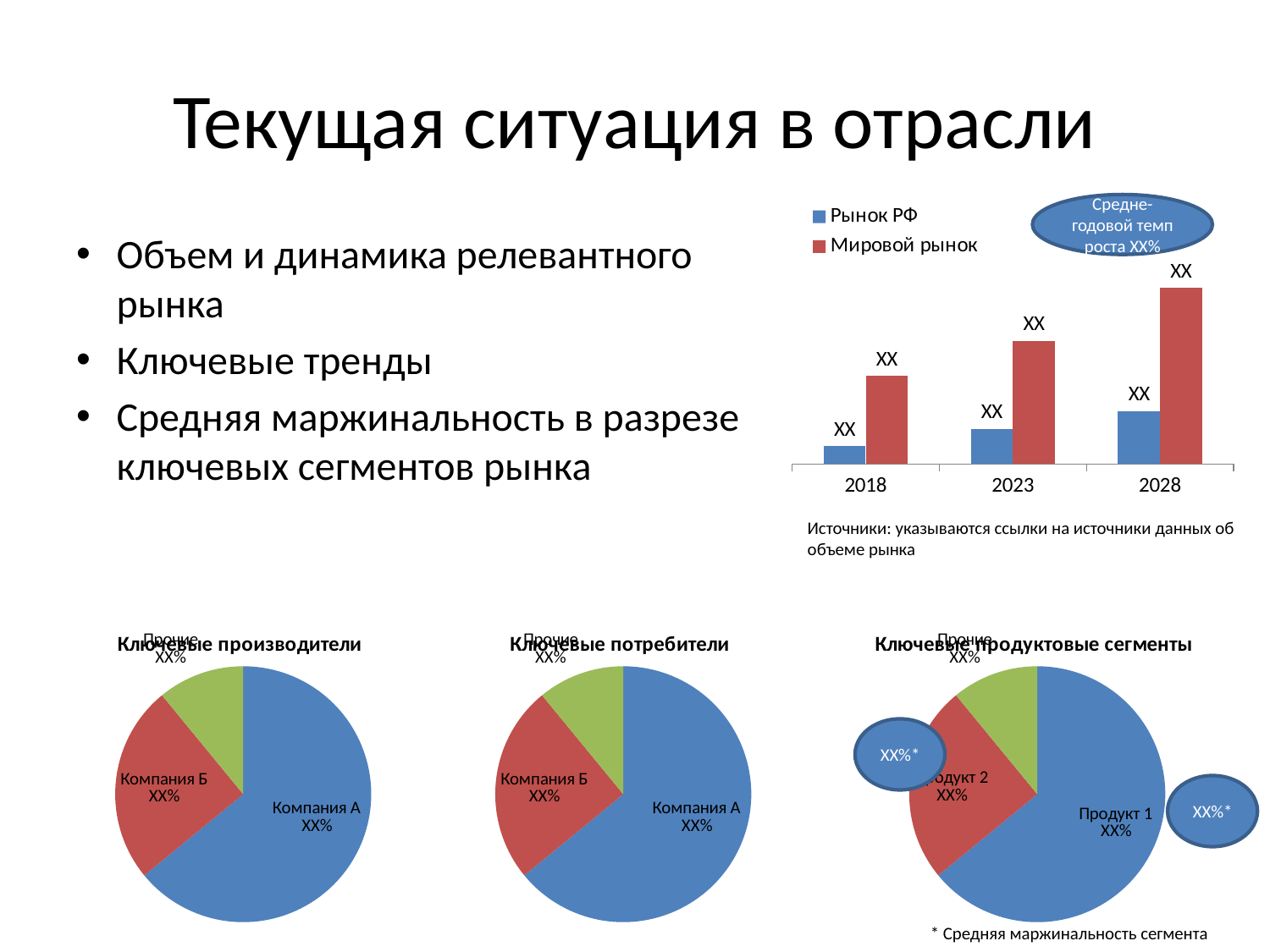
In the chart titled 'Ключевые продуктовые сегменты', which category has the smallest slice? Прочие In the chart titled 'Ключевые производители', which category has the largest slice? Компания А What kind of chart is the chart in the top right of the slide showing 2018, 2023 and 2028? bar chart In the top-right bar chart, which year has the lowest value for Рынок РФ? 2018 How many series does the legend of the top-right bar chart list? 2 In the top-right bar chart, which year has the highest value for Мировой рынок? 2028 What are the two series named in the legend of the top-right bar chart? Рынок РФ and Мировой рынок How many year categories are shown on the x axis of the top-right bar chart? 3 In the top-right bar chart, which series is larger in 2023: Рынок РФ or Мировой рынок? Мировой рынок What kind of chart is the chart titled 'Ключевые производители'? pie chart In the top-right bar chart, do the values for Мировой рынок rise or fall from 2018 to 2028? rise In the top-right bar chart, do the values for Рынок РФ rise or fall from 2018 to 2028? rise